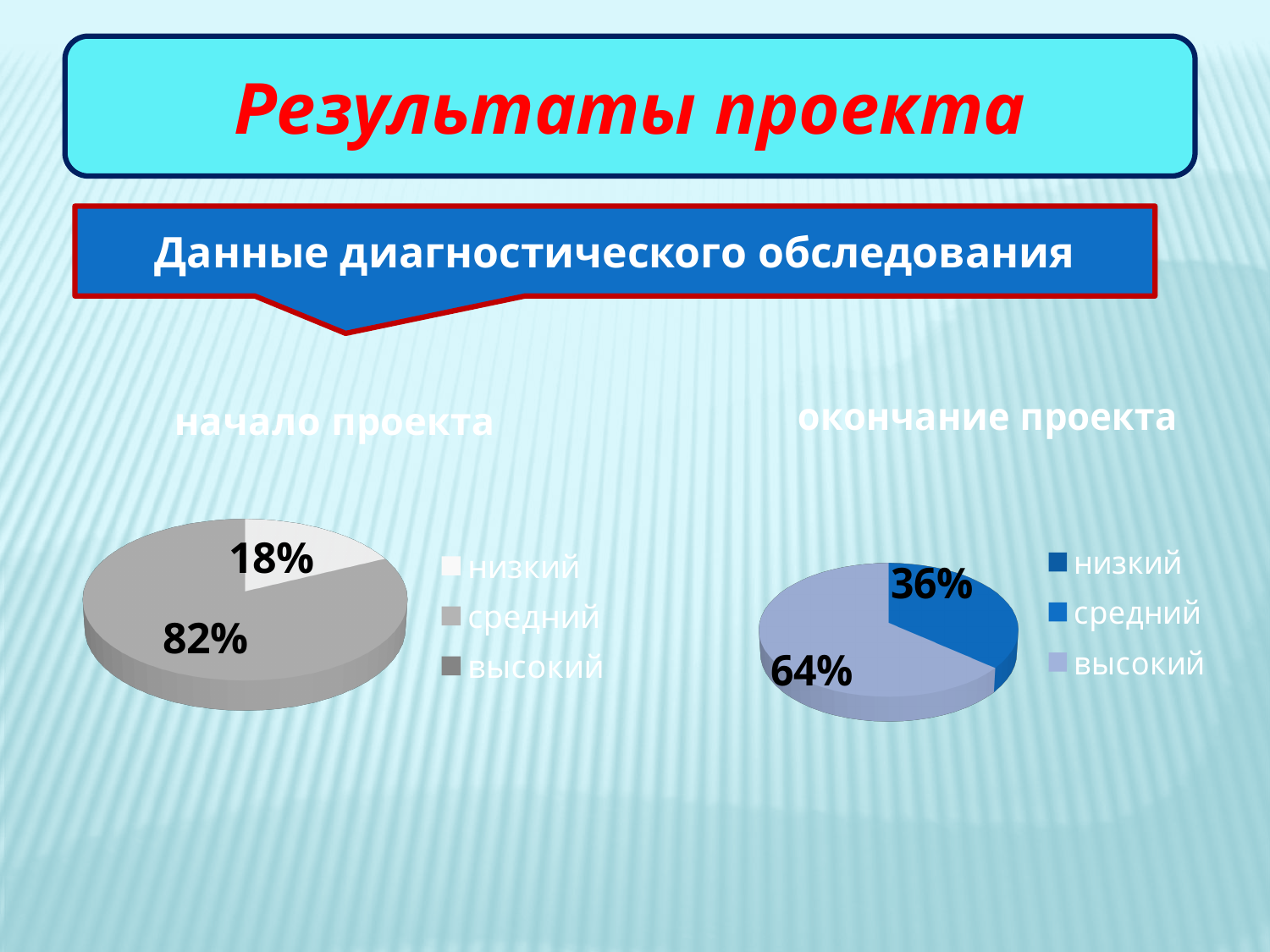
How many entries does the legend of the chart titled "окончание проекта" list? 3 What are the three legend entries of the chart titled "начало проекта"? низкий, средний, высокий What type of chart is the chart titled "начало проекта"? pie chart In the chart titled "начало проекта", what is the difference between the two labelled slices? 64% In the chart titled "начало проекта", what percentage is shown for the larger slice? 82% In the chart titled "начало проекта", what percentage is shown for the smaller slice? 18% In the chart titled "окончание проекта", what percentage is shown for the larger slice? 64% How many entries does the legend of the chart titled "начало проекта" list? 3 Which is larger: the 36% slice in the chart titled "окончание проекта" or the 18% slice in the chart titled "начало проекта"? the 36% slice in "окончание проекта" What type of chart is the chart titled "окончание проекта"? pie chart In the chart titled "окончание проекта", what percentage is shown for the smaller slice? 36% In the chart titled "окончание проекта", what is the difference between the two labelled slices? 28%